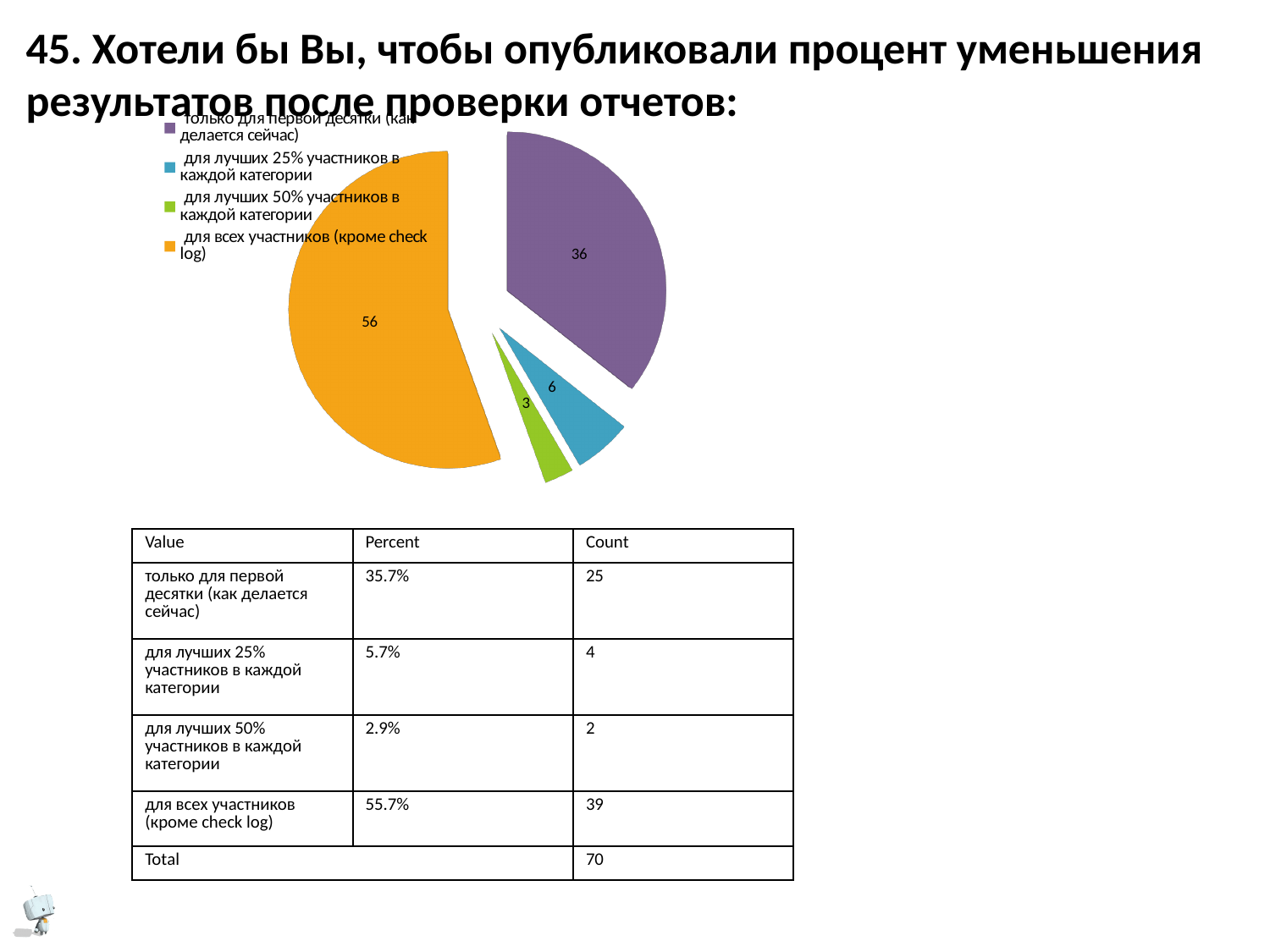
What is the difference between the labelled values of the 'для всех участников (кроме check log)' slice and the 'только для первой десятки (как делается сейчас)' slice? 20 What value is labelled on the pie slice for 'для лучших 50% участников в каждой категории'? 3 Which slice is larger: 'для лучших 25% участников в каждой категории' or 'для лучших 50% участников в каждой категории'? для лучших 25% участников в каждой категории What kind of chart is shown on the slide? pie chart What colour is the slice for 'для всех участников (кроме check log)' in the pie chart? orange What value is labelled on the pie slice for 'только для первой десятки (как делается сейчас)'? 36 What value is labelled on the pie slice for 'для лучших 25% участников в каждой категории'? 6 How many entries does the legend of the pie chart list? 4 Which category has the smallest slice in the pie chart? для лучших 50% участников в каждой категории Which category has the largest slice in the pie chart? для всех участников (кроме check log) How many slices does the pie chart have? 4 What value is labelled on the pie slice for 'для всех участников (кроме check log)'? 56